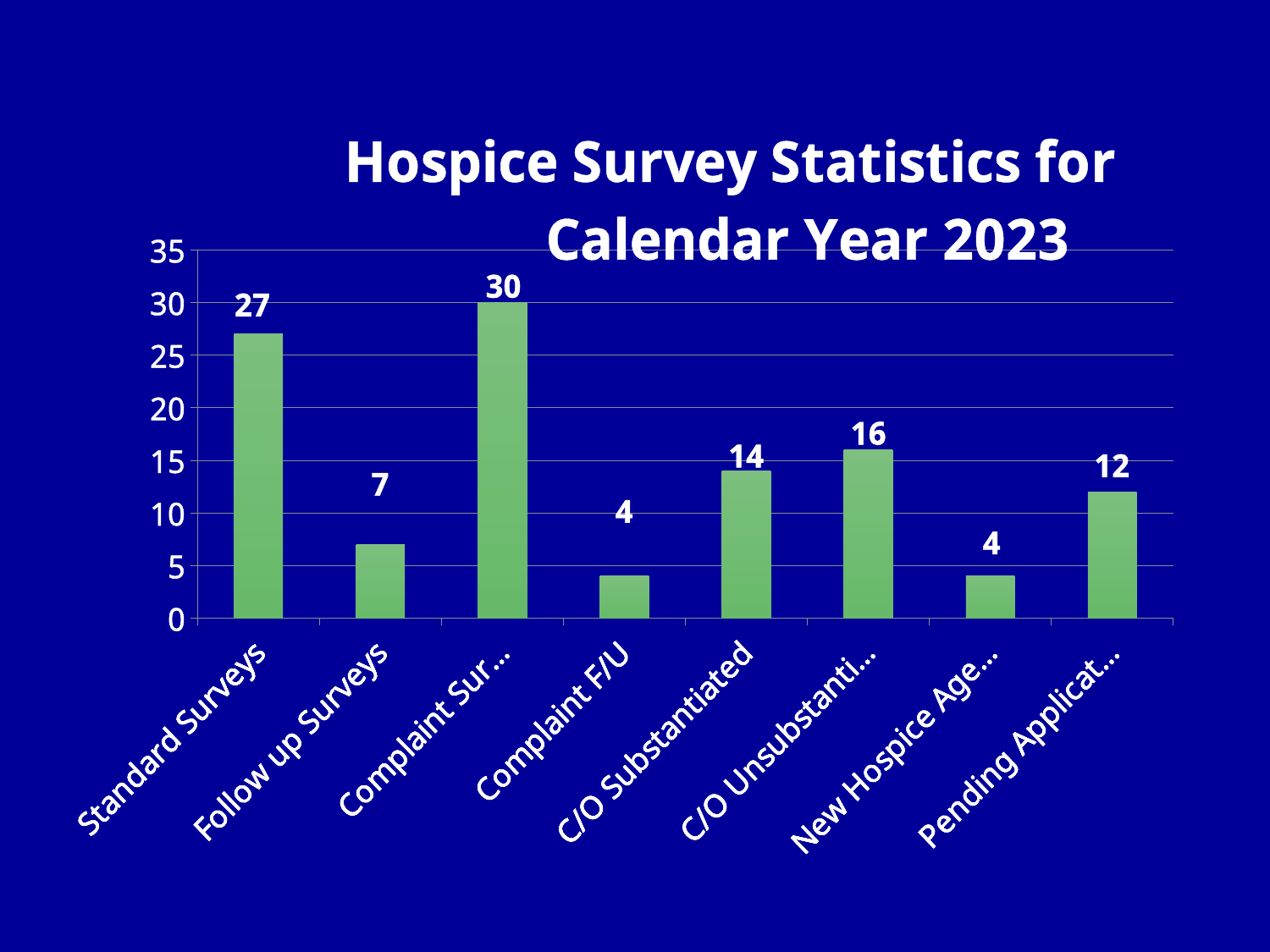
Which category has the highest value? Complaint Sur... What is the title of the chart? Hospice Survey Statistics for Calendar Year 2023 What is the value for Complaint F/U? 4 What is the difference between the values for Standard Surveys and Follow up Surveys? 20 What is the difference between the values for C/O Substantiated and Complaint F/U? 10 What kind of chart is shown on the slide? bar chart Which is larger, the value for Standard Surveys or the value for C/O Substantiated? Standard Surveys What is the value for C/O Substantiated? 14 Is the value for Standard Surveys greater or less than 25? greater What is the value for Follow up Surveys? 7 How many categories are shown on the x axis? 8 What is the value for Standard Surveys? 27